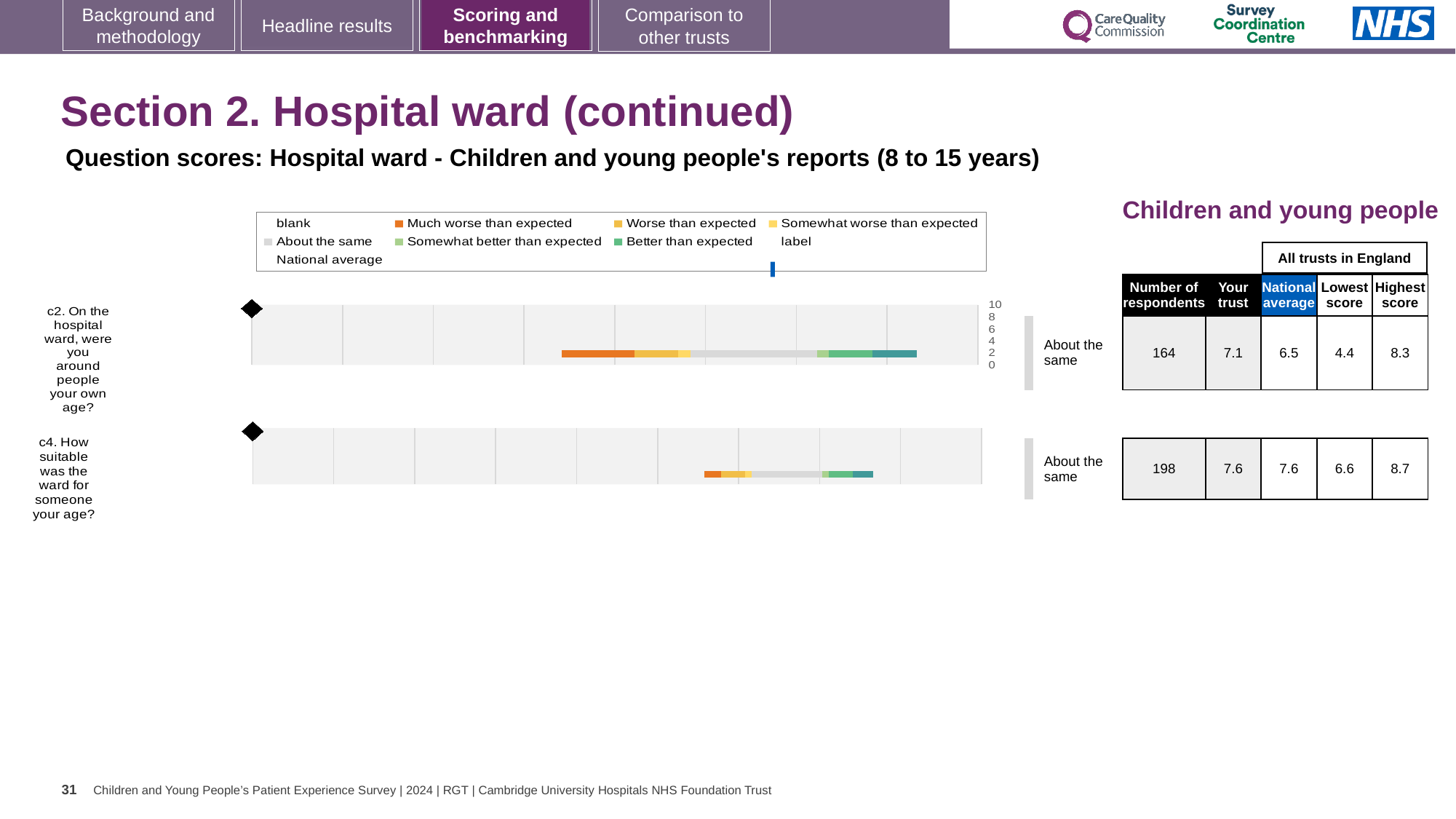
What is the difference in the number of respondents between question c4 and question c2? 34 What is the national average score for question c4 (How suitable was the ward for someone your age?)? 7.6 What benchmark category is shown for question c2? About the same How many survey questions are plotted as bars on the slide? 2 Which question has the higher 'Your trust' score, c2 or c4? c4 What is the highest score among all trusts in England for question c4? 8.7 What kind of chart is used to show the question scores? bar chart How many respondents answered question c2? 164 What is the 'Your trust' score for question c2 (On the hospital ward, were you around people your own age?)? 7.1 Which colour in the legend represents 'Much worse than expected'? Orange What is the lowest score among all trusts in England for question c2? 4.4 What is the difference between the trust's score and the national average for question c2? 0.6